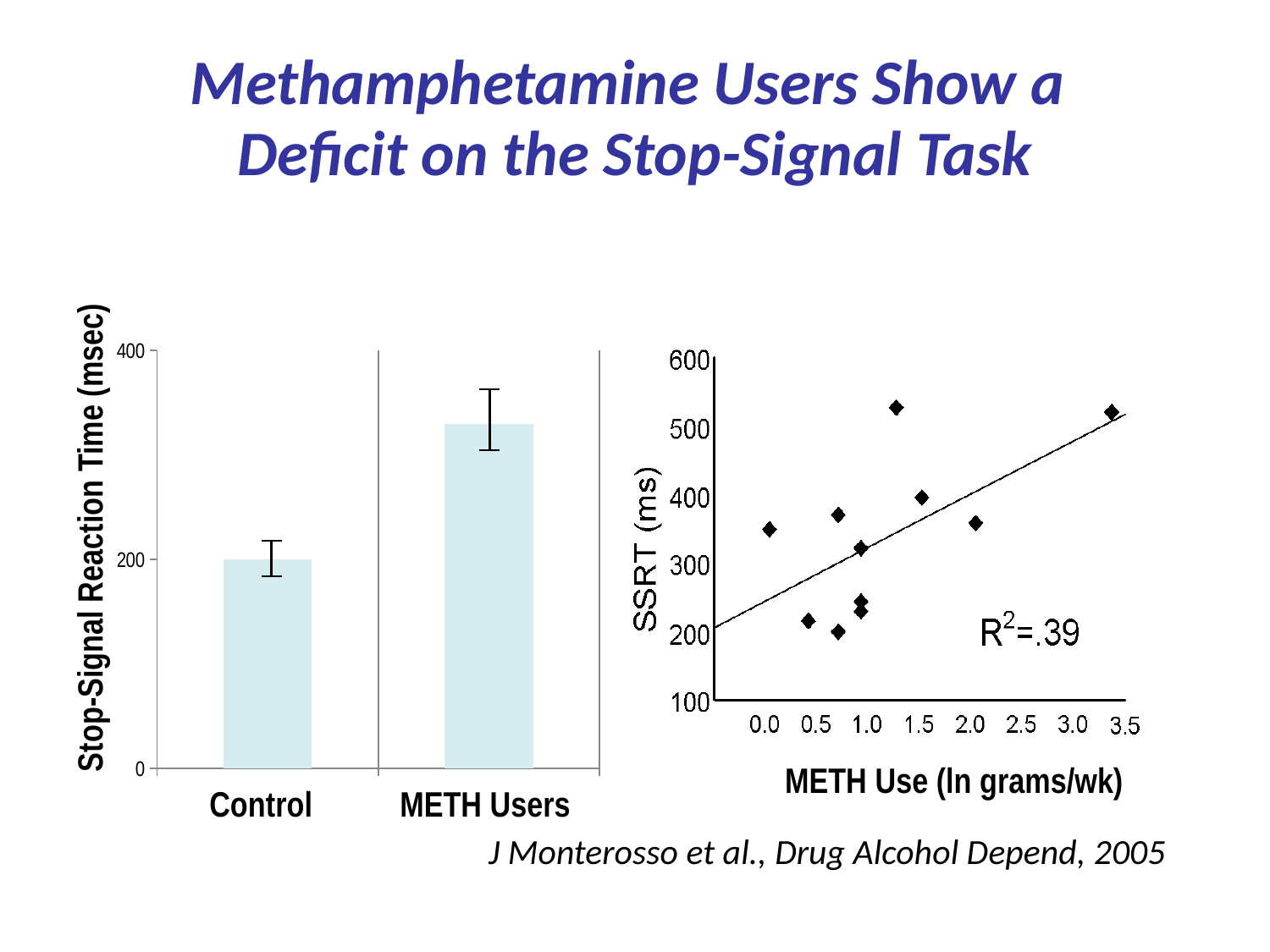
What R-squared value is printed on the right scatter plot? R²=.39 On the left bar chart, is the value for METH Users greater or less than 200? greater What is the x-axis label of the right scatter plot? METH Use (ln grams/wk) On the left bar chart, is the value for METH Users greater or less than 400? less On the left bar chart, which group has the lower Stop-Signal Reaction Time? Control On the left bar chart, what is the Stop-Signal Reaction Time for Control? 200 What kind of chart is the right chart plotting SSRT against METH Use? scatter plot What kind of chart is the left chart comparing Control and METH Users? bar chart On the left bar chart, which group has the higher Stop-Signal Reaction Time? METH Users On the right scatter plot, does SSRT tend to rise or fall as METH Use increases? rise On the left bar chart, is the bar for Control or for METH Users taller? METH Users How many categories are shown on the left bar chart? 2